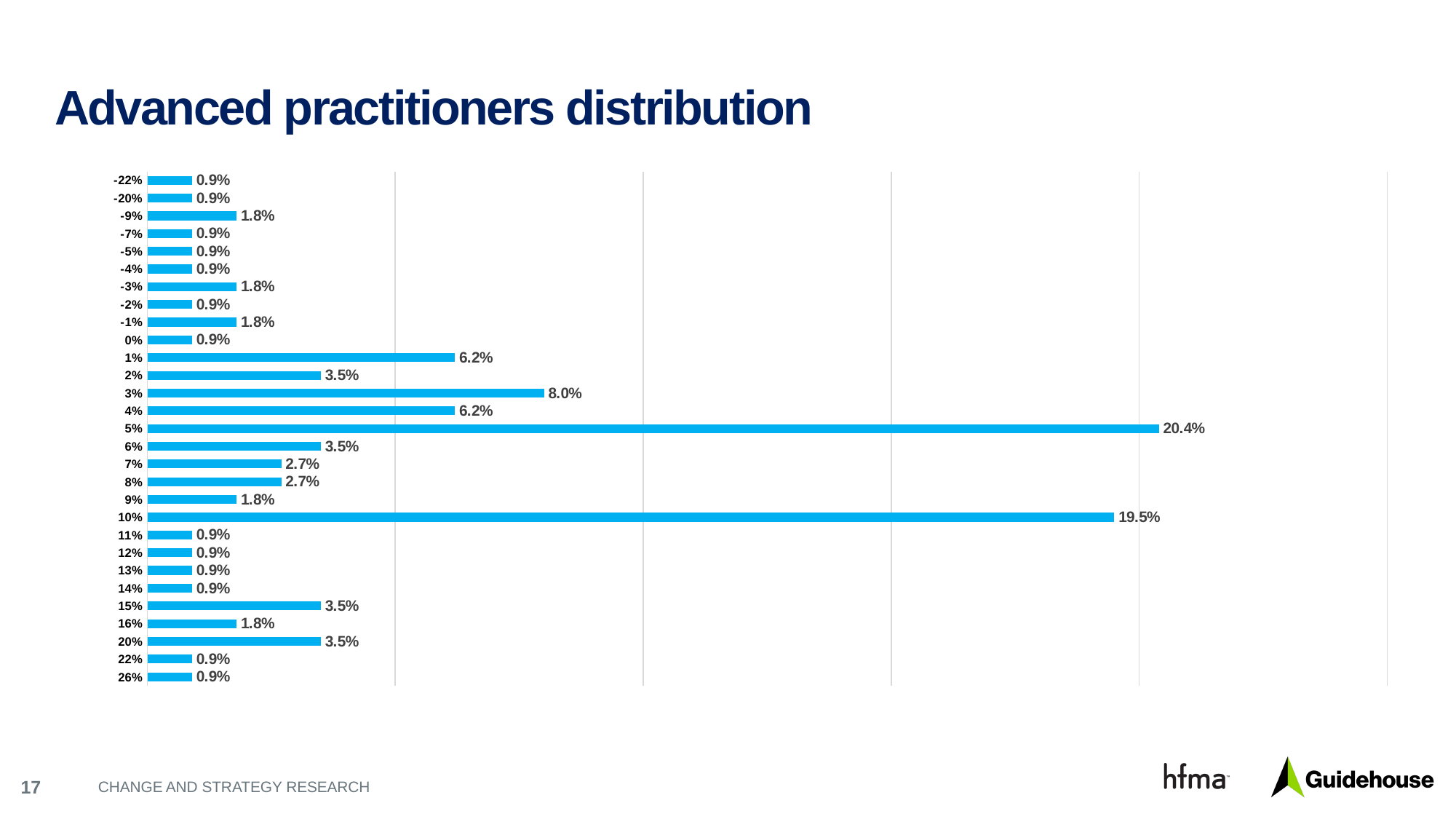
What kind of chart is shown on the slide? Bar chart How many categories are shown on the chart? 29 Which is larger, the value for the 2% category or the value for the 7% category? 2% What is the difference between the values for the 3% and 1% categories? 1.8% What is the value for the 10% category? 19.5% What is the value for the 15% category? 3.5% What is the value for the 3% category? 8.0% What is the difference between the values for the 5% and 10% categories? 0.9% What is the title of the slide? Advanced practitioners distribution What is the value for the 5% category? 20.4% What is the value for the -9% category? 1.8% Which category has the highest value? 5%